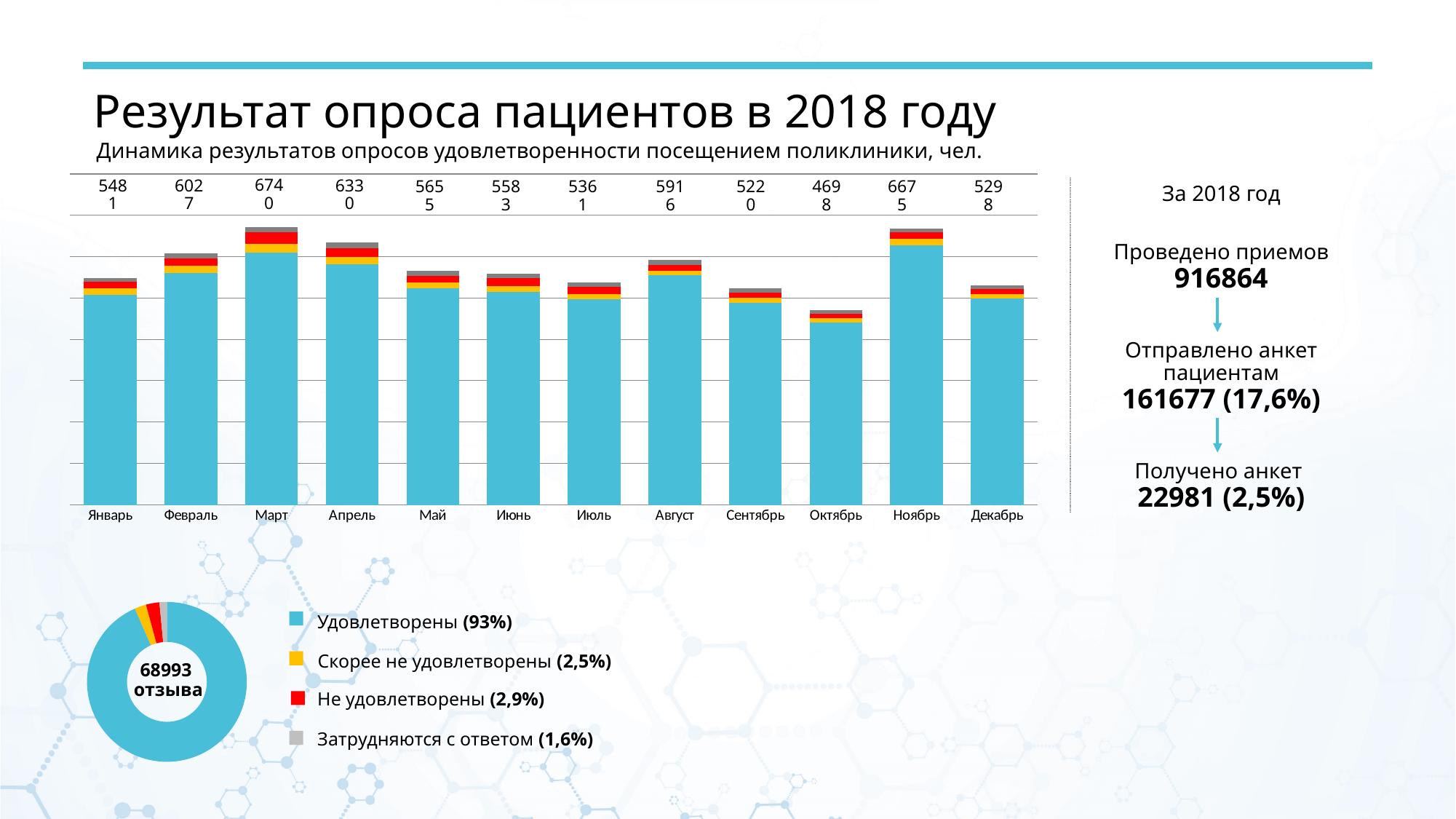
In the monthly bar chart, how many months are shown on the x axis? 12 In the donut chart at the bottom left, what share is shown for 'Не удовлетворены'? 2,9% In the monthly bar chart, what total is printed above the bar for Ноябрь? 6675 What kind of chart is the monthly chart under the heading 'Динамика результатов опросов удовлетворенности посещением поликлиники, чел.'? bar chart In the monthly bar chart, what total is printed above the bar for Январь? 5481 In the monthly bar chart, which has the larger printed total, Февраль or Ноябрь? Ноябрь In the donut chart at the bottom left, what share is shown for 'Удовлетворены'? 93% In the monthly bar chart, what is the difference between the totals printed for Март and Октябрь? 2042 In the monthly bar chart, which month has the lowest total printed above its bar? Октябрь How many categories does the legend of the donut chart at the bottom left list? 4 In the monthly bar chart, which month has the highest total printed above its bar? Март In the monthly bar chart, do the printed totals rise or fall from Август to Октябрь? fall